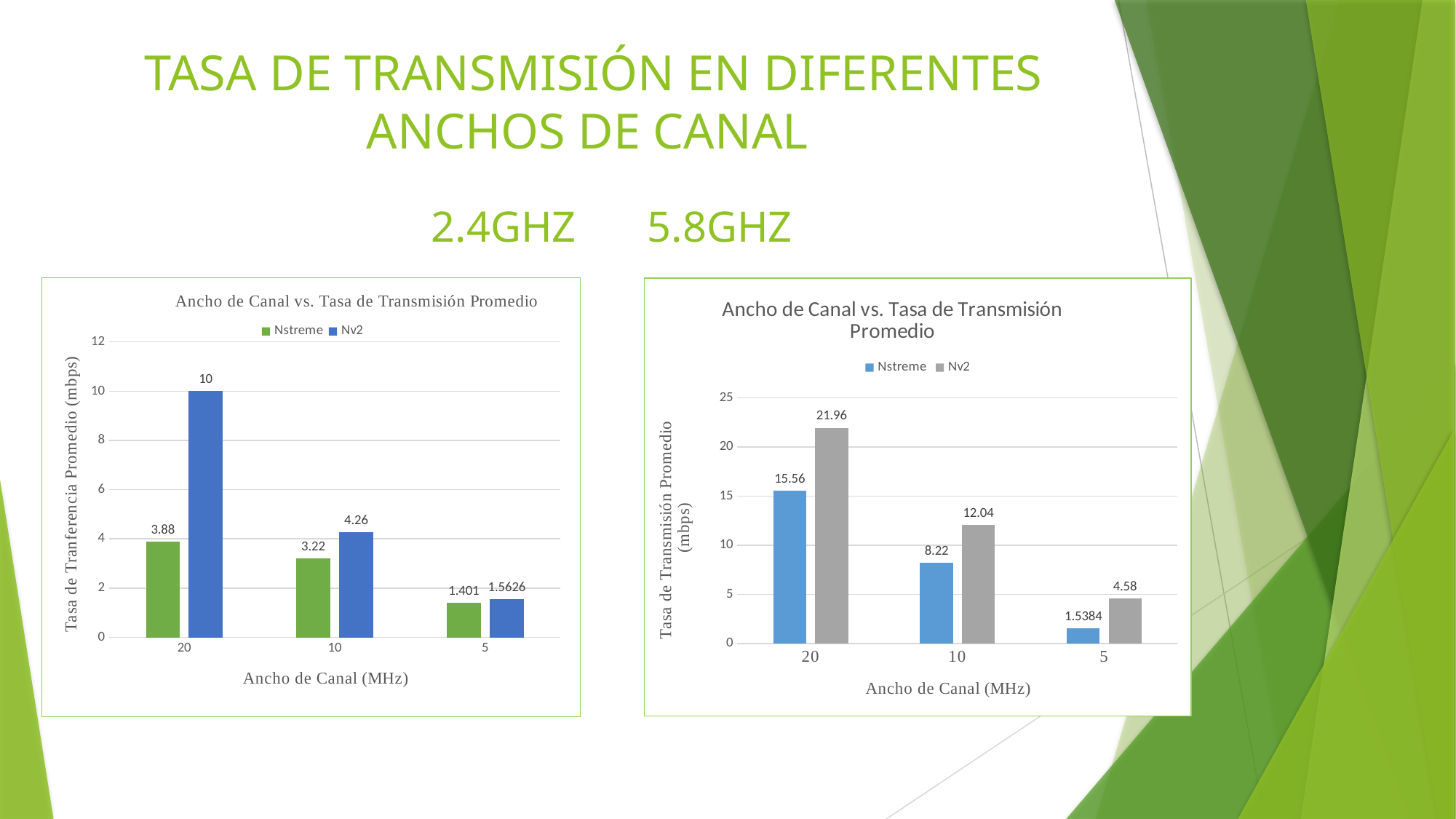
In the 5.8GHZ chart (right), what is the value for Nv2 at 10 MHz? 12.04 In the 5.8GHZ chart (right), what is the value for Nstreme at 5 MHz? 1.5384 How many channel width categories are shown on the x axis of the 2.4GHZ chart (left)? 3 In the 2.4GHZ chart (left), what is the value for Nstreme at 5 MHz? 1.401 In the 2.4GHZ chart (left), what is the value for Nv2 at 20 MHz? 10 In the 2.4GHZ chart (left), which channel width has the lowest Nv2 value? 5 What kind of chart is the 2.4GHZ chart (left)? Bar chart In the 5.8GHZ chart (right), what is the difference between the Nv2 and Nstreme values at 20 MHz? 6.4 In the 5.8GHZ chart (right), is the value for Nv2 at 20 MHz greater or less than 20? greater How many series does the legend of the 5.8GHZ chart (right) list? 2 In the 2.4GHZ chart (left), which is larger at 10 MHz, Nstreme or Nv2? Nv2 In the 5.8GHZ chart (right), which channel width has the highest Nstreme value? 20